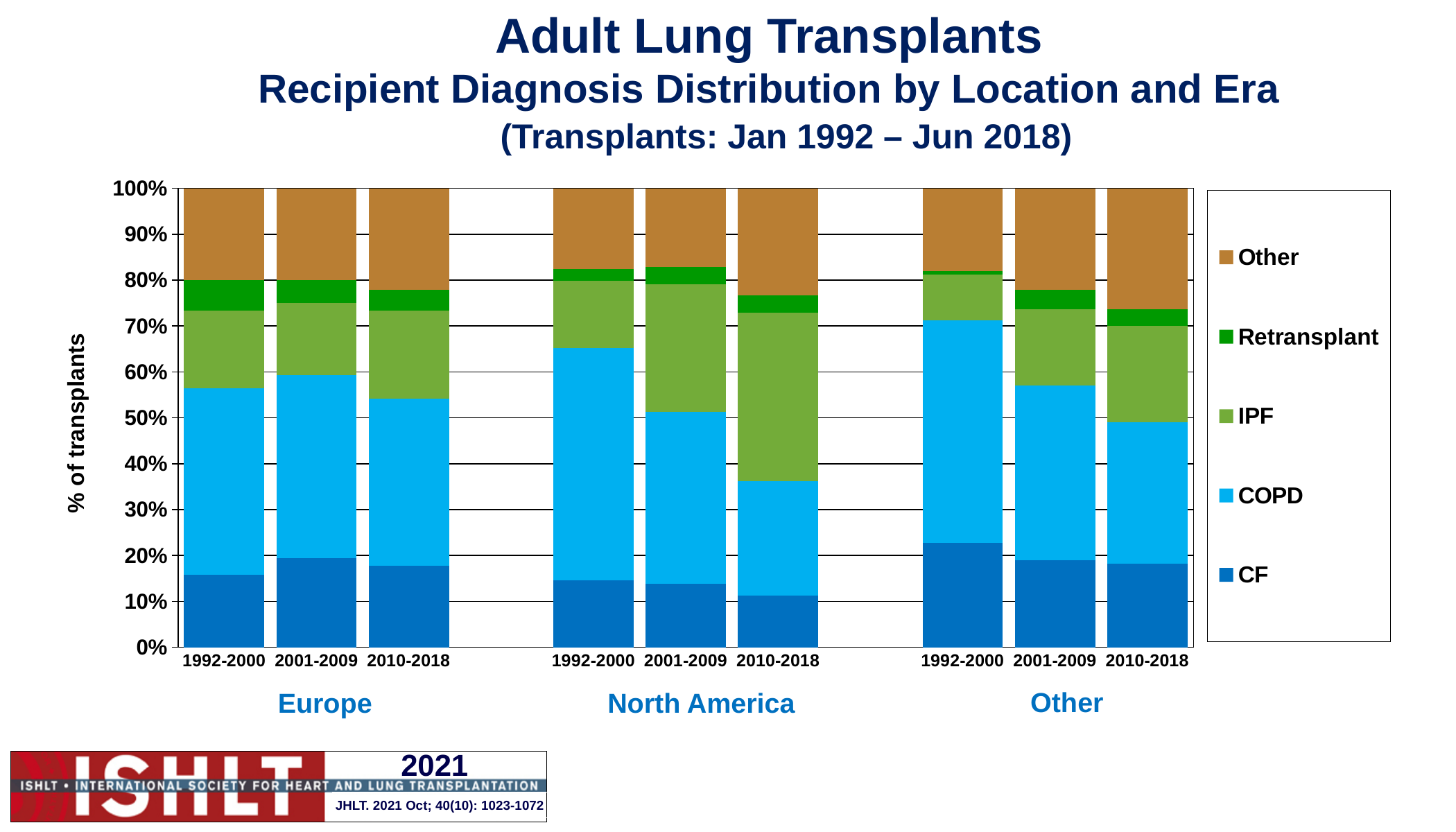
Is the CF share for the Other region in 1992-2000 greater or less than 20%? greater Which bar has the largest IPF segment? North America 2010-2018 How many series does the legend list? 5 Is the combined share of CF and COPD for North America in 1992-2000 greater or less than 60%? greater What kind of chart is shown on the slide? Stacked bar chart Does the IPF share for North America rise or fall across the three eras from 1992-2000 to 2010-2018? rises How many regions are shown along the x axis? 3 What is the label on the y axis of the chart? % of transplants Does the COPD share for the Other region rise or fall across the three eras from 1992-2000 to 2010-2018? falls Which is larger: the CF share for Europe in 1992-2000 or the CF share for the Other region in 1992-2000? Other region 1992-2000 How many bars are plotted in the chart? 9 Is the CF share for North America in 2010-2018 greater or less than 20%? less